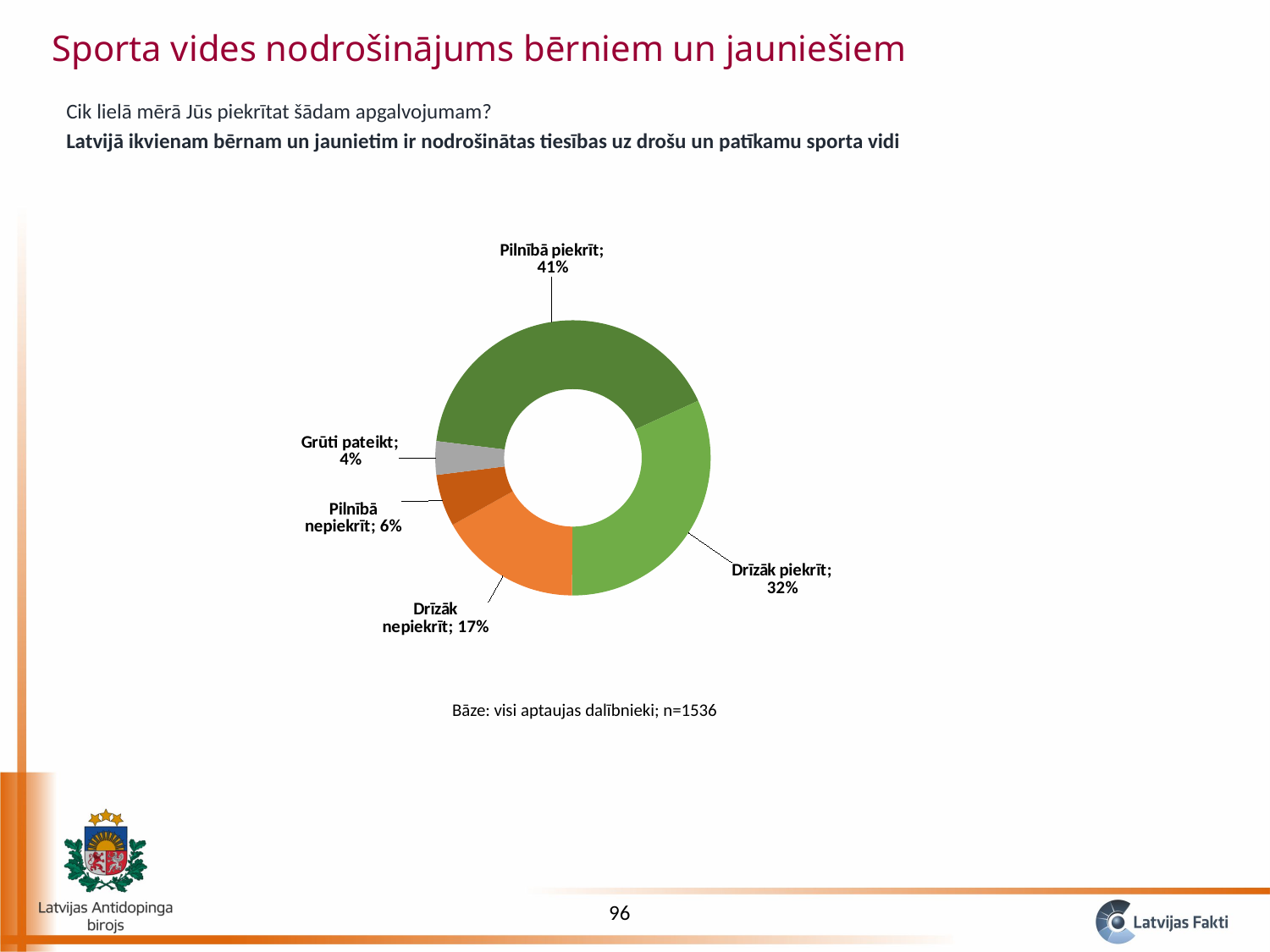
Which response category has the largest share? Pilnībā piekrīt Which response category has the smallest share? Grūti pateikt What kind of chart is shown on the slide? Doughnut (pie) chart What is the base (n) of respondents stated below the chart? n=1536 What percentage of respondents answered "Pilnībā piekrīt"? 41% How many response categories are shown in the chart? 5 What percentage of respondents answered "Drīzāk nepiekrīt"? 17% What percentage of respondents answered "Drīzāk piekrīt"? 32% What percentage of respondents answered "Pilnībā nepiekrīt"? 6% What is the difference in percentage points between "Pilnībā piekrīt" and "Drīzāk piekrīt"? 9 What percentage of respondents answered "Grūti pateikt"? 4% Which is larger: the share for "Drīzāk nepiekrīt" or for "Pilnībā nepiekrīt"? Drīzāk nepiekrīt